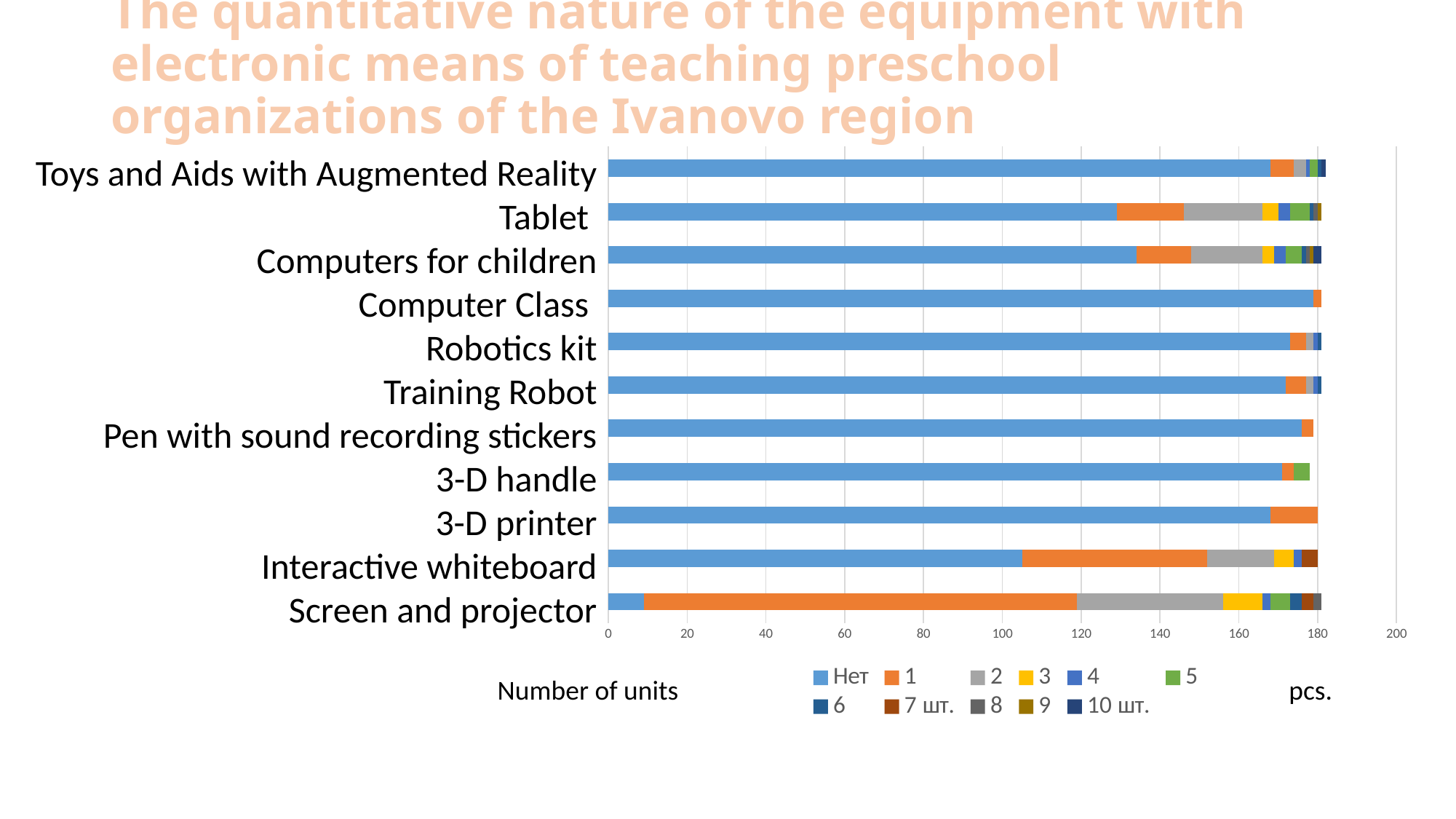
Which equipment category has the largest '1' segment? Screen and projector Which equipment category has the smallest 'Нет' (none) segment? Screen and projector Is the 'Нет' value for Screen and projector greater or less than 20? less How many equipment categories are listed on the vertical axis of the chart? 11 How many series does the chart's legend list? 11 What is the first entry in the chart's legend? Нет Is the 'Нет' value for Computer Class greater or less than 160? greater Which has a larger 'Нет' segment: Interactive whiteboard or Screen and projector? Interactive whiteboard Is the 'Нет' value for Interactive whiteboard greater or less than 100? greater What is the label shown below the horizontal axis of the chart? Number of units What kind of chart is shown on the slide? stacked bar chart